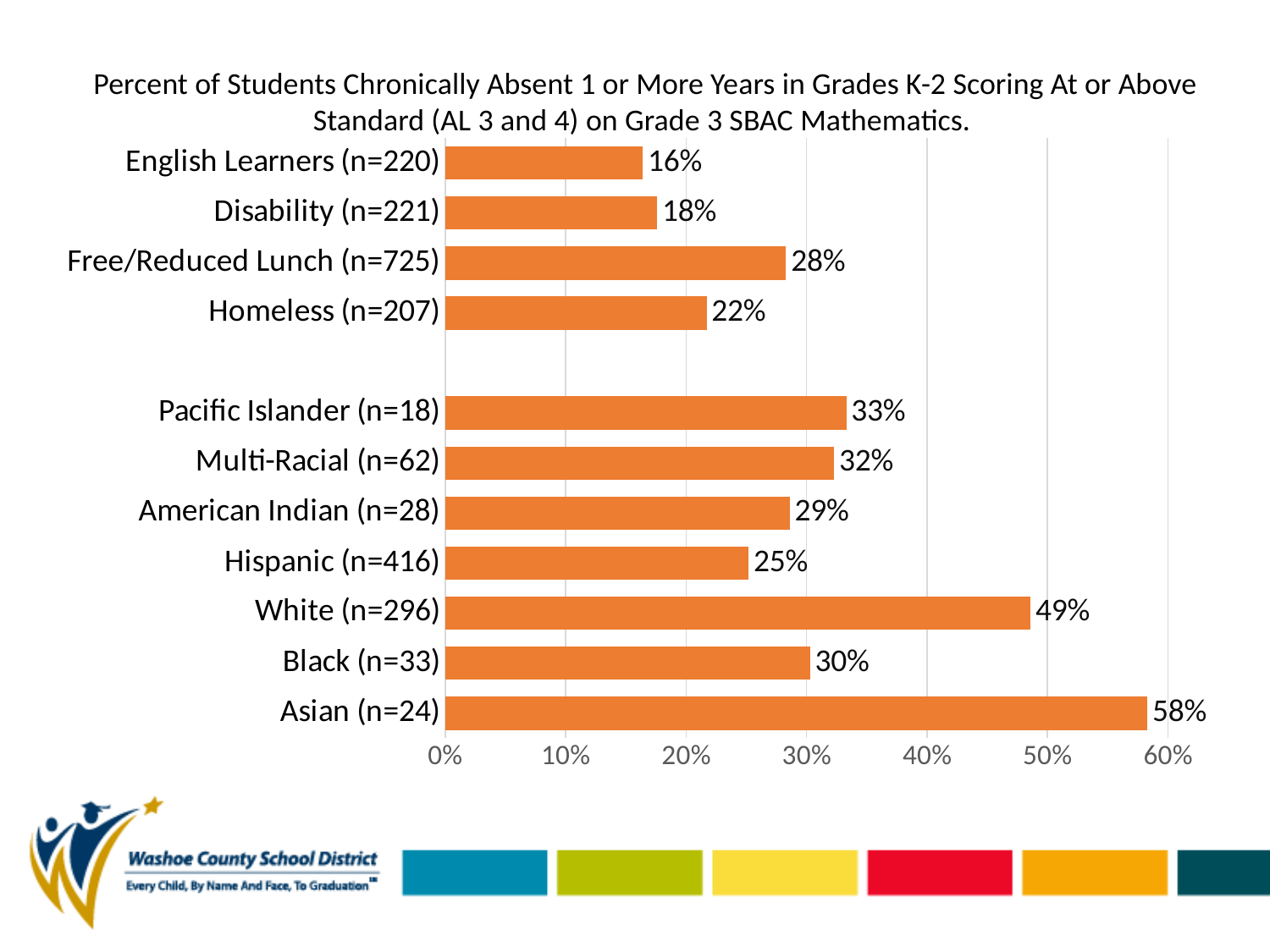
How many categories have bars in the chart? 11 What is the title of the chart? Percent of Students Chronically Absent 1 or More Years in Grades K-2 Scoring At or Above Standard (AL 3 and 4) on Grade 3 SBAC Mathematics. What is the value for English Learners (n=220)? 16% Which category has the lowest value? English Learners (n=220) What is the value for Asian (n=24)? 58% What is the difference between the values for Disability (n=221) and English Learners (n=220)? 2% Is the value for Black (n=33) greater or less than 40%? less Which category has the highest value? Asian (n=24) What is the difference between the values for White (n=296) and Hispanic (n=416)? 24% Which is larger, the value for Free/Reduced Lunch (n=725) or Homeless (n=207)? Free/Reduced Lunch (n=725) What is the value for Hispanic (n=416)? 25% What kind of chart is shown on the slide? bar chart